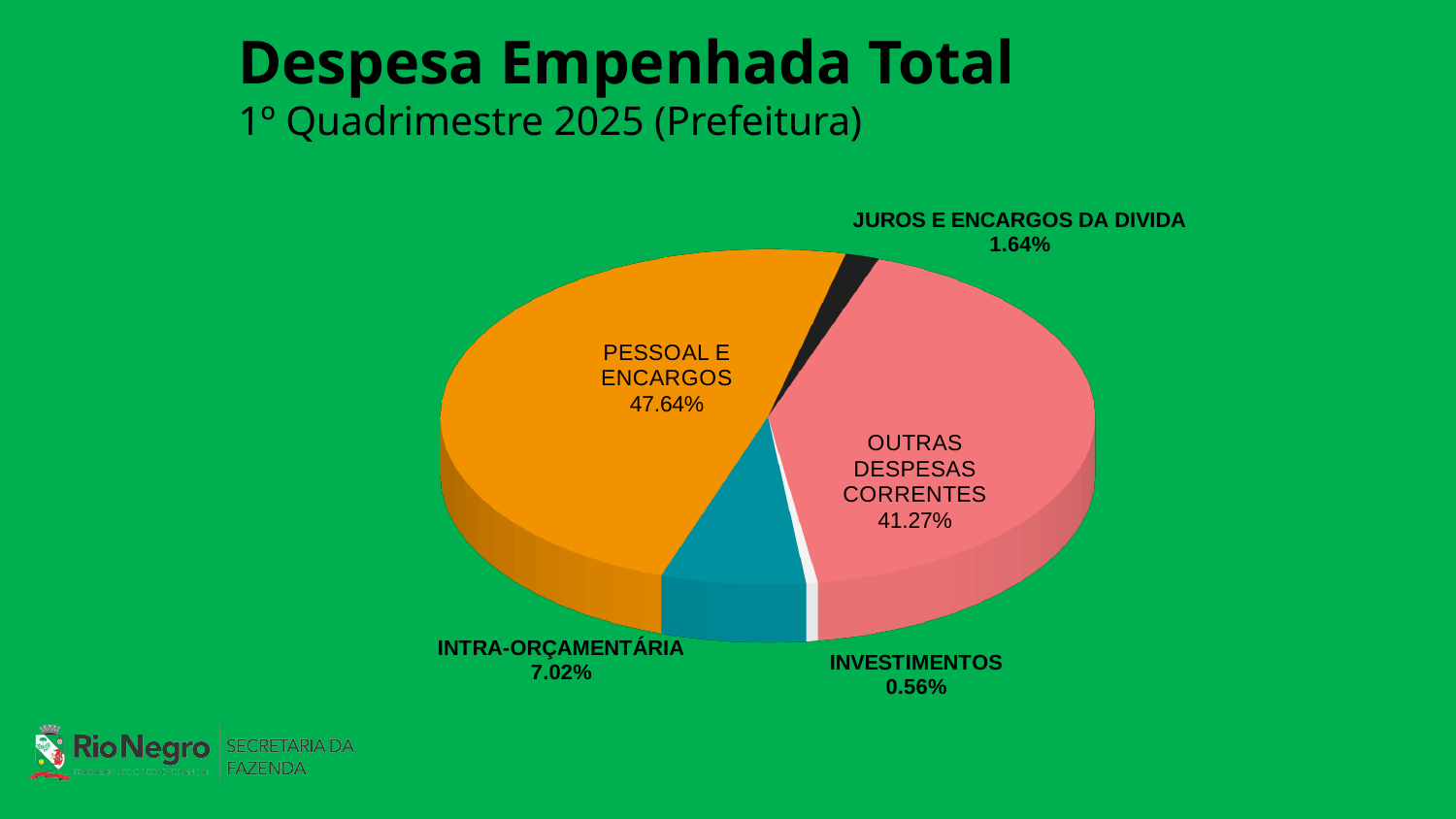
What is the difference in percentage points between PESSOAL E ENCARGOS and OUTRAS DESPESAS CORRENTES? 6.37 Which category has the largest share of the pie? PESSOAL E ENCARGOS What percentage is shown for JUROS E ENCARGOS DA DIVIDA? 1.64% What kind of chart is shown on the slide? Pie chart Which category has the smallest share of the pie? INVESTIMENTOS What is the title of the chart on the slide? Despesa Empenhada Total What is the value for INTRA-ORÇAMENTÁRIA? 7.02% What is the value shown for OUTRAS DESPESAS CORRENTES? 41.27% What share of the pie does PESSOAL E ENCARGOS represent? 47.64% Which is larger, INTRA-ORÇAMENTÁRIA or JUROS E ENCARGOS DA DIVIDA? INTRA-ORÇAMENTÁRIA What percentage is shown for INVESTIMENTOS? 0.56%